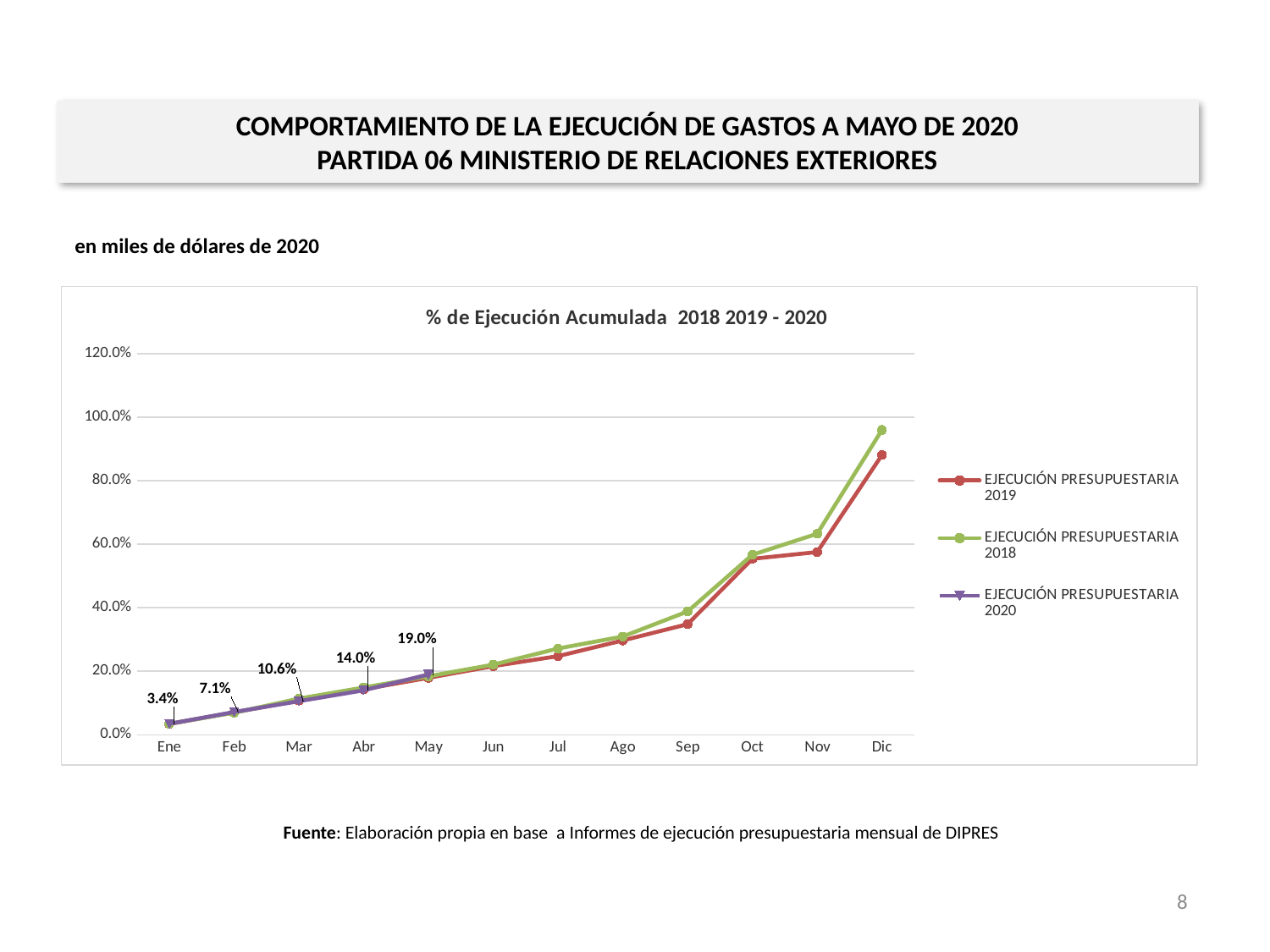
Do the values for EJECUCIÓN PRESUPUESTARIA 2018 rise or fall from Ene to Dic? Rise What is the value for EJECUCIÓN PRESUPUESTARIA 2020 in May? 19.0% What kind of chart is shown on the slide? Line chart What is the value for EJECUCIÓN PRESUPUESTARIA 2020 in Ene? 3.4% What is the title of the chart? % de Ejecución Acumulada 2018 2019 - 2020 Is the value for EJECUCIÓN PRESUPUESTARIA 2018 in Dic greater or less than 80.0%? greater What is the value for EJECUCIÓN PRESUPUESTARIA 2020 in Mar? 10.6% Is the value for EJECUCIÓN PRESUPUESTARIA 2019 in Nov greater or less than 60.0%? less How many months are shown on the x axis? 12 How many series does the legend list? 3 In Dic, which series has the higher value, EJECUCIÓN PRESUPUESTARIA 2018 or EJECUCIÓN PRESUPUESTARIA 2019? EJECUCIÓN PRESUPUESTARIA 2018 What is the difference between the EJECUCIÓN PRESUPUESTARIA 2020 values for May and Ene? 15.6 percentage points